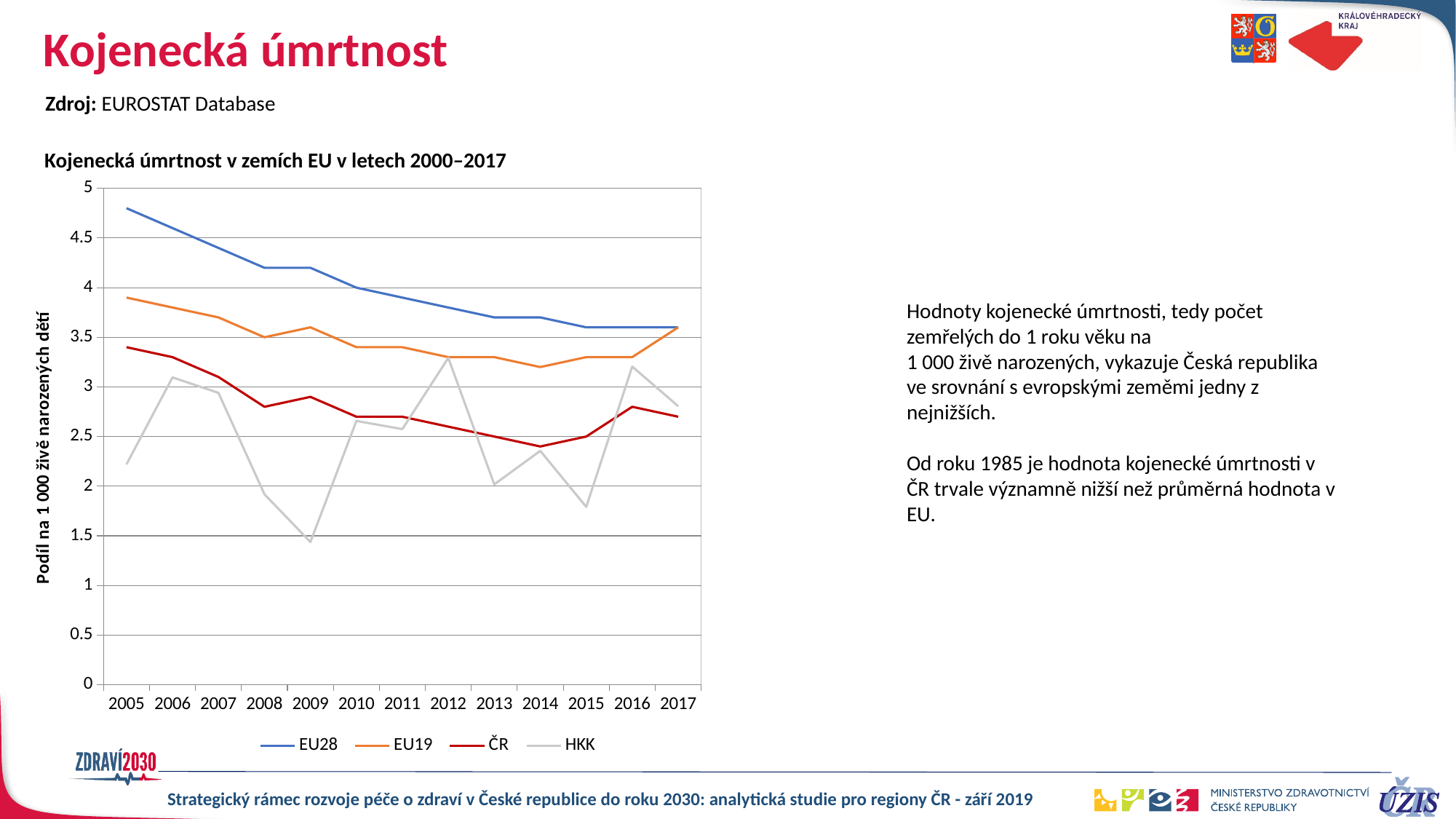
Which series has the lowest value in 2009? HKK Which is larger in 2017, the value for EU28 or the value for ČR? EU28 What is the label of the y axis? Podíl na 1 000 živě narozených dětí How many years are shown on the x axis? 13 Is the value for HKK in 2009 greater or less than 2? less How many series does the legend list? 4 Is the value for EU28 in 2005 greater or less than 4.5? greater Does the EU28 series rise or fall from 2005 to 2017? fall What kind of chart is shown on the slide? line chart Is the value for ČR in 2014 greater or less than 3? less Which series has the highest value in 2005? EU28